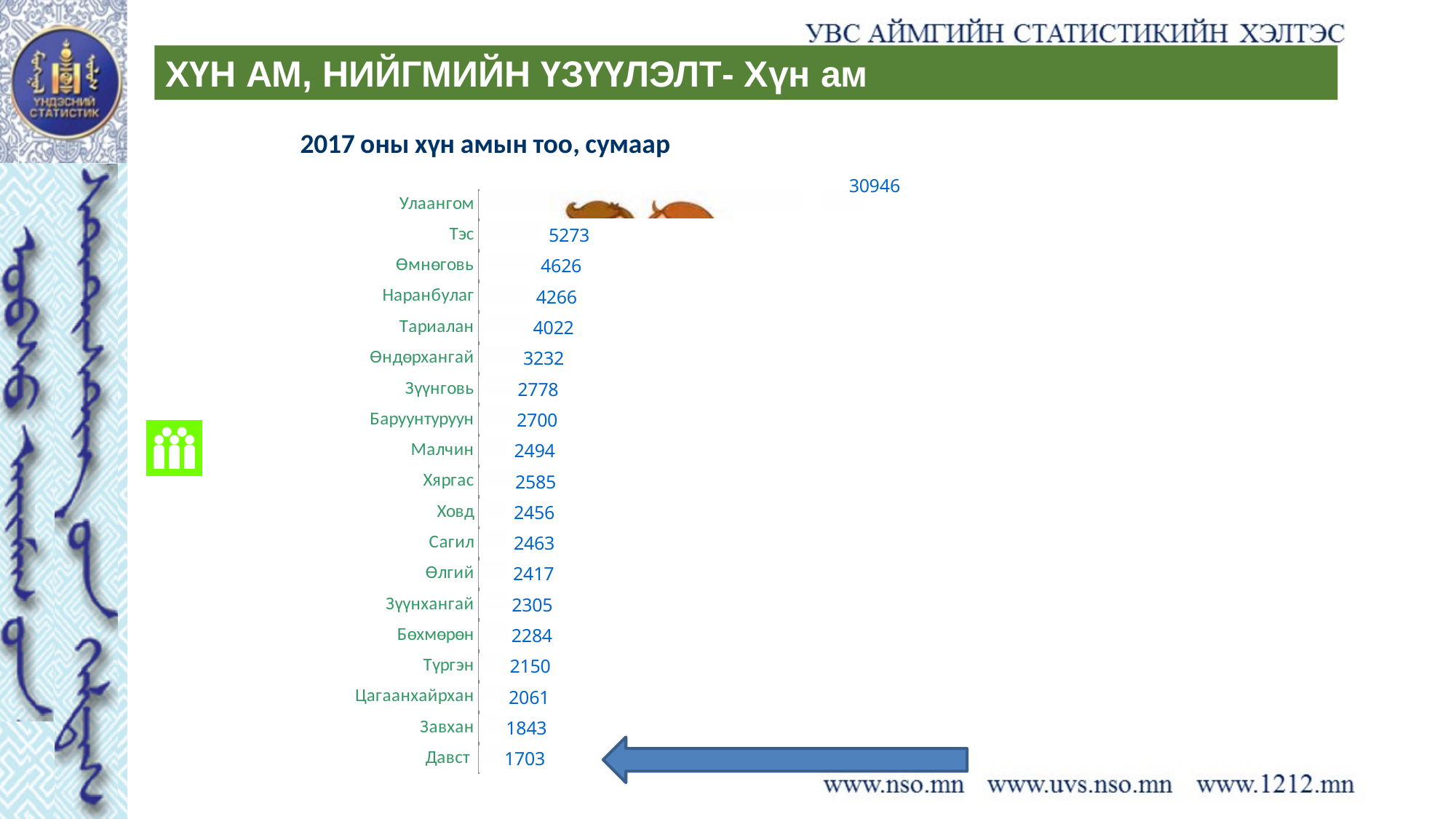
Which soum has the lowest population in the chart? Давст What is the value shown for Давст? 1703 What is the population value shown for Улаангом? 30946 How many soums (categories) are listed in the chart? 19 What is the difference between the values for Тэс and Өмнөговь? 647 Which has a larger value, Хяргас or Малчин? Хяргас What is the difference between the values for Завхан and Давст? 140 What is the value shown for Баруунтуруун? 2700 Which soum has the highest population in the chart? Улаангом What type of chart is shown on the slide? Bar chart What is the title of the chart? 2017 оны хүн амын тоо, сумаар What is the population value shown for Тэс? 5273